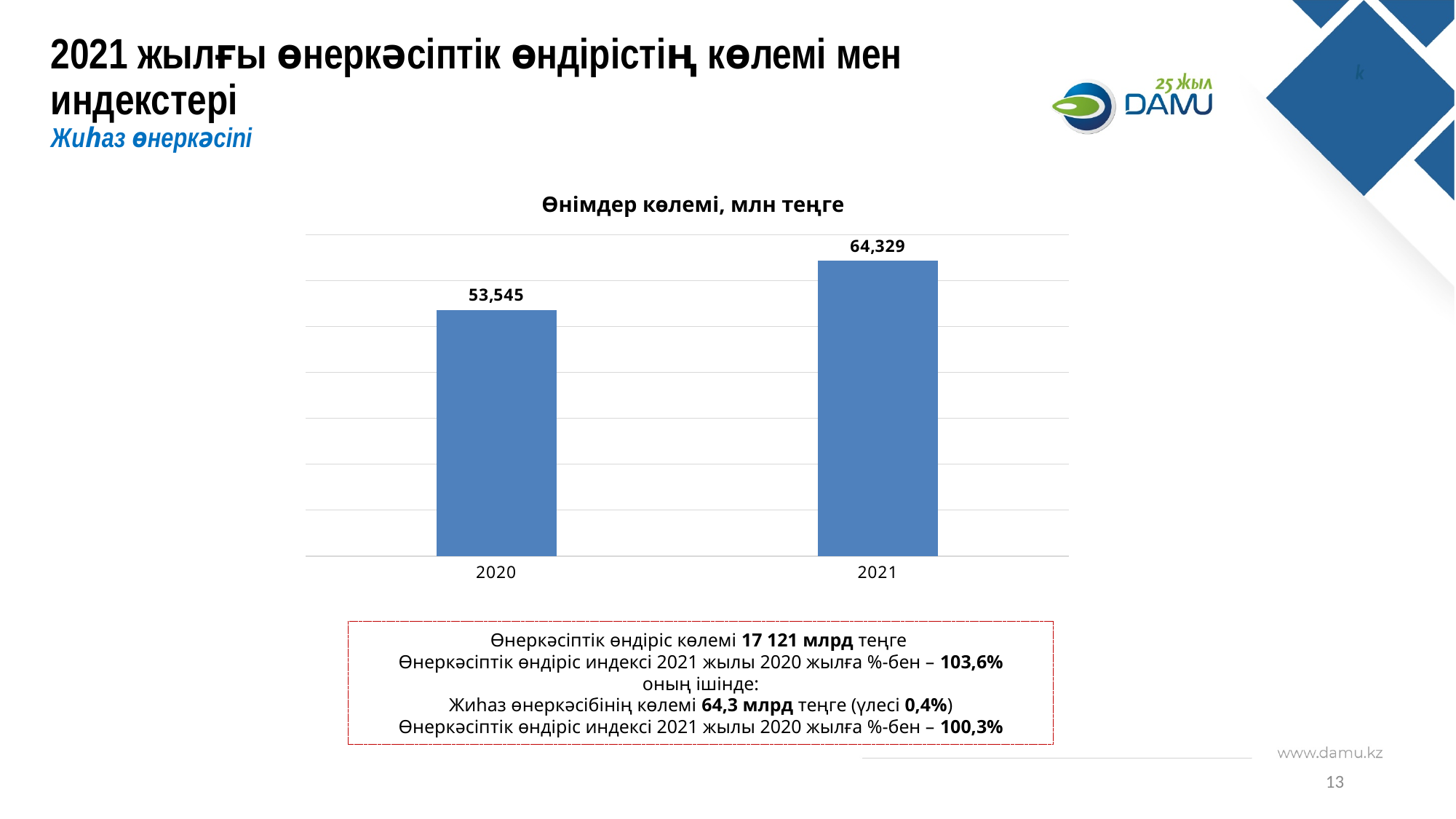
What is the value for 2021 in the chart? 64,329 What is the difference between the 2021 and 2020 values in the chart? 10,784 What is the value for 2020 in the chart? 53,545 What colour are the bars in the chart? blue Is the value for 2021 larger or smaller than the value for 2020? larger What is the title of the chart? Өнімдер көлемі, млн теңге Which year has the lower value in the chart? 2020 How many bars are shown in the chart? 2 What type of chart is shown on the slide? bar chart Do the values rise or fall from 2020 to 2021? rise Which year has the higher value in the chart? 2021